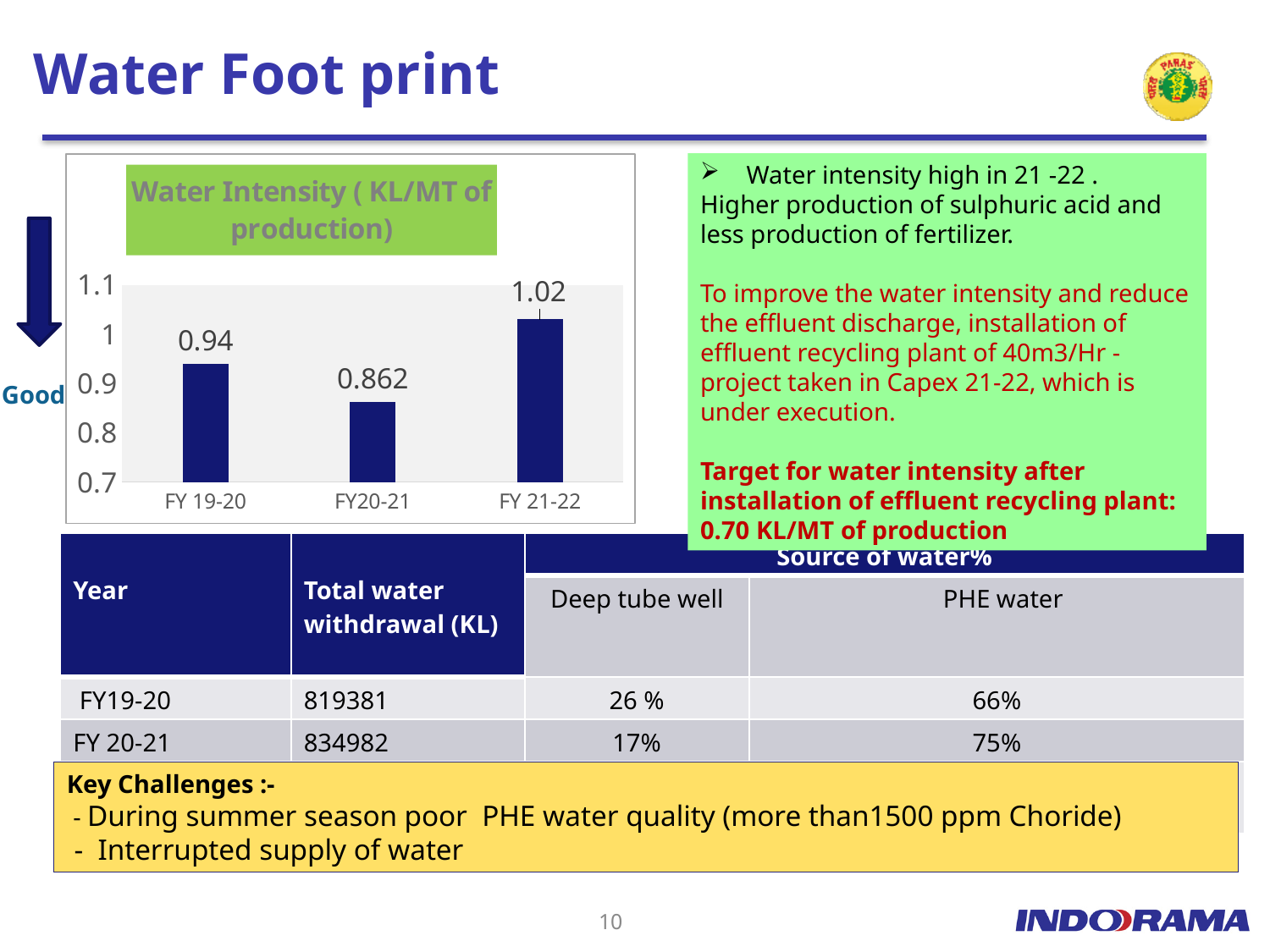
Is the water intensity for FY 21-22 greater or less than 1? greater What type of chart is used to show water intensity? bar chart What is the title of the chart? Water Intensity ( KL/MT of production) Which fiscal year has the highest water intensity? FY 21-22 Which is larger, the water intensity for FY 19-20 or for FY20-21? FY 19-20 What is the difference in water intensity between FY 19-20 and FY20-21? 0.078 What is the water intensity value for FY 19-20? 0.94 Which fiscal year has the lowest water intensity? FY20-21 What is the water intensity value for FY 21-22? 1.02 What is the difference in water intensity between FY 21-22 and FY 19-20? 0.08 What is the water intensity value for FY20-21? 0.862 How many fiscal years are shown in the water intensity chart? 3